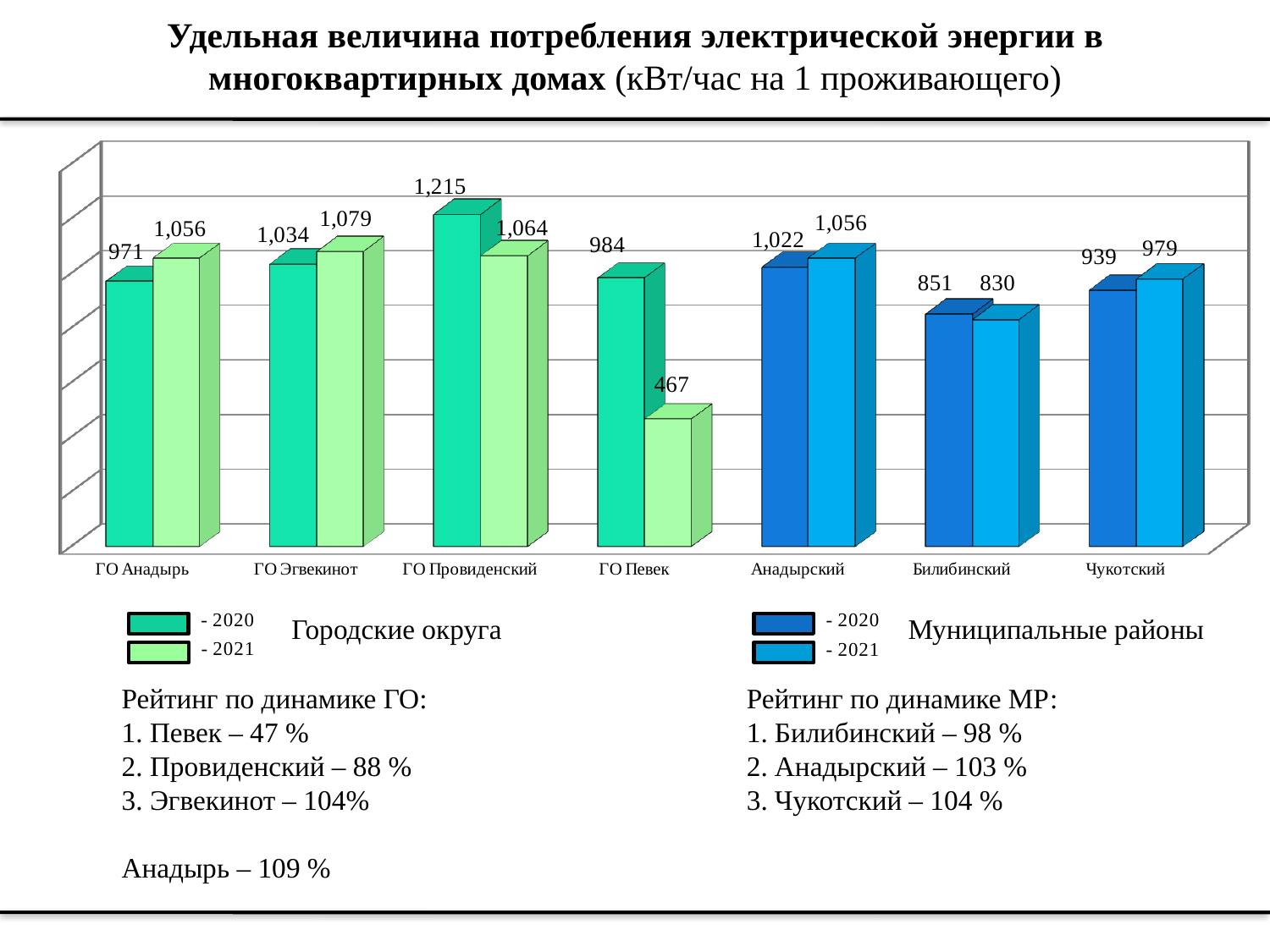
Which two years does the legend for Городские округа list? 2020 and 2021 What is the 2020 value for ГО Провиденский? 1,215 Which category has the highest 2020 value? ГО Провиденский What is the difference between the 2020 and 2021 values for ГО Певек? 517 How many categories are shown on the x axis of the chart? 7 What is the difference between the 2020 and 2021 values for ГО Анадырь? 85 What kind of chart is shown on the slide? Bar chart Which category has the lowest 2021 value? ГО Певек What is the 2021 value for Билибинский? 830 Which is larger for Билибинский: the 2020 value or the 2021 value? 2020 What is the 2020 value for Чукотский? 939 What is the 2021 value for ГО Певек? 467